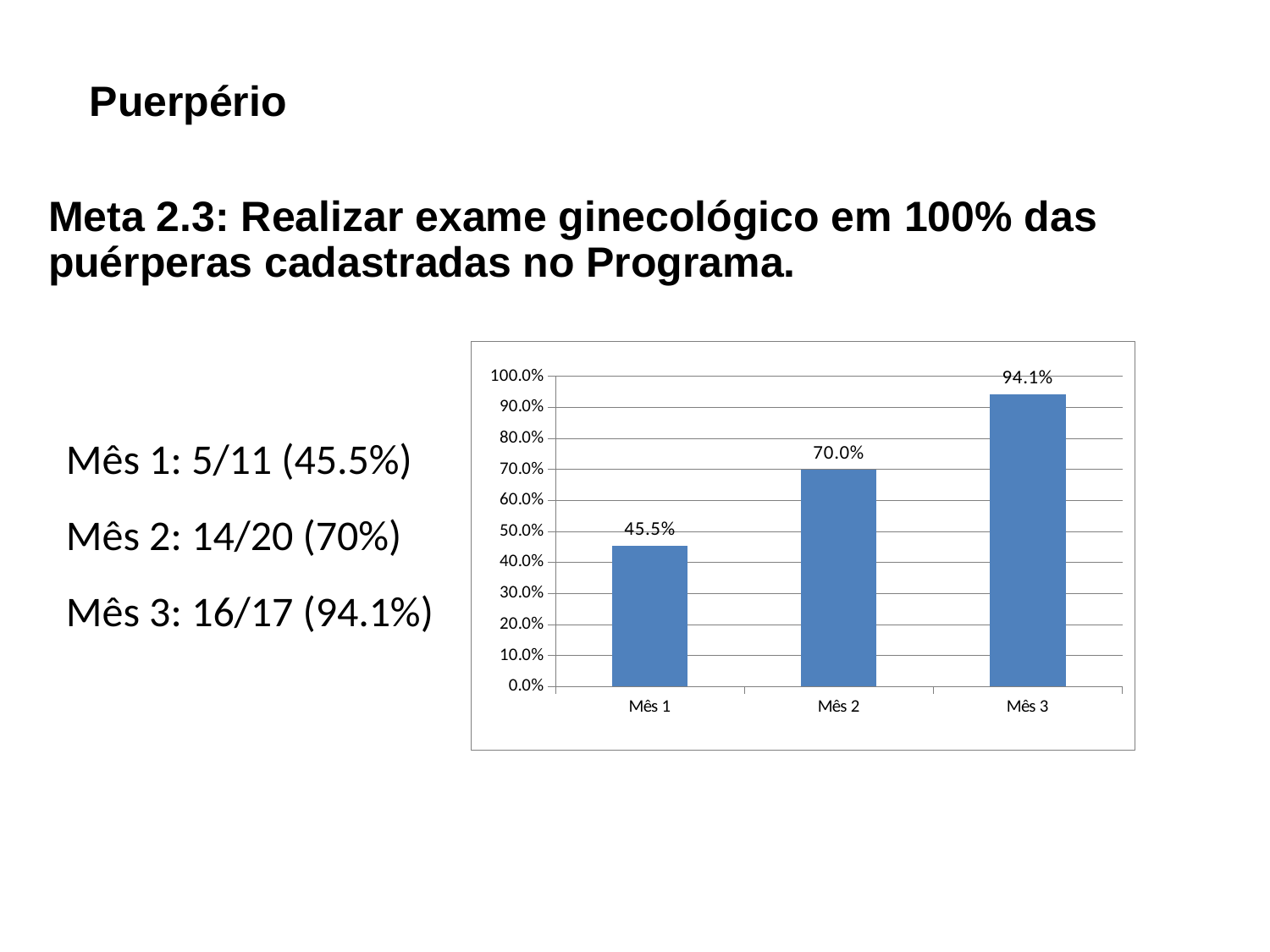
Which month has the lowest value? Mês 1 Is the value for Mês 1 greater or less than 50.0%? less What is the value for Mês 3? 94.1% Which month has the highest value? Mês 3 What is the value for Mês 1? 45.5% Do the values rise or fall from Mês 1 to Mês 3? rise What is the difference between the values for Mês 3 and Mês 1? 48.6% What is the difference between the values for Mês 2 and Mês 1? 24.5% What kind of chart is shown on the slide? bar chart Which is larger, the value for Mês 2 or the value for Mês 3? Mês 3 What is the value for Mês 2? 70.0% How many categories are shown on the x axis? 3